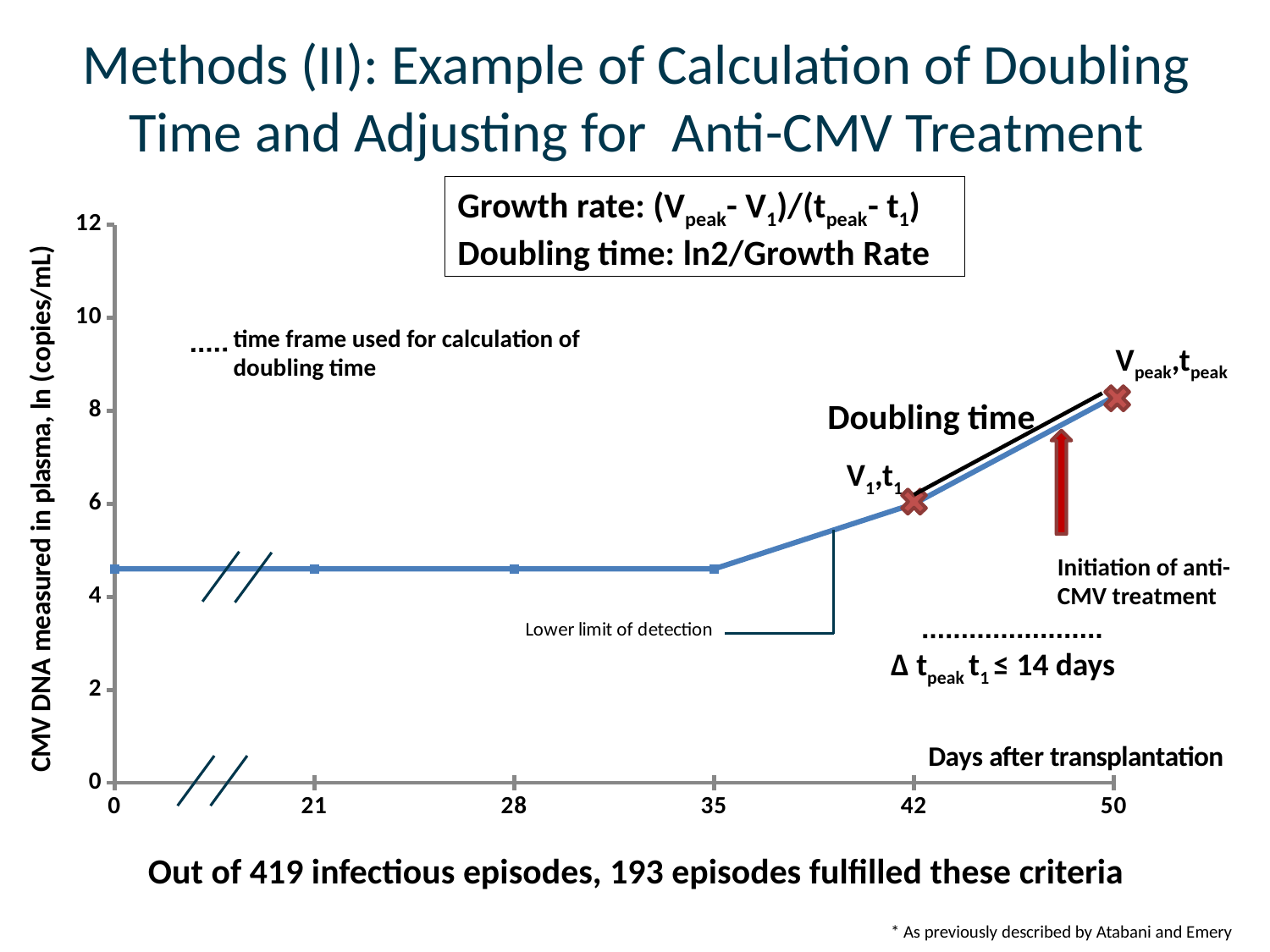
How many tick labels are shown on the x axis? 6 Is the value at day 21 greater or less than 6? less What is the label of the x axis? Days after transplantation Which is larger, the value at day 42 or the value at day 50? day 50 Does the plotted line rise, fall, or stay flat between day 0 and day 35? stay flat At which day after transplantation is the plotted CMV DNA value highest? 50 Is the value at day 50 greater or less than 6? greater What is the label of the y axis? CMV DNA measured in plasma, ln (copies/mL) Does the plotted line rise or fall between day 35 and day 50? rise Is the value at day 42 greater or less than 4? greater What kind of chart is shown on the slide? line chart